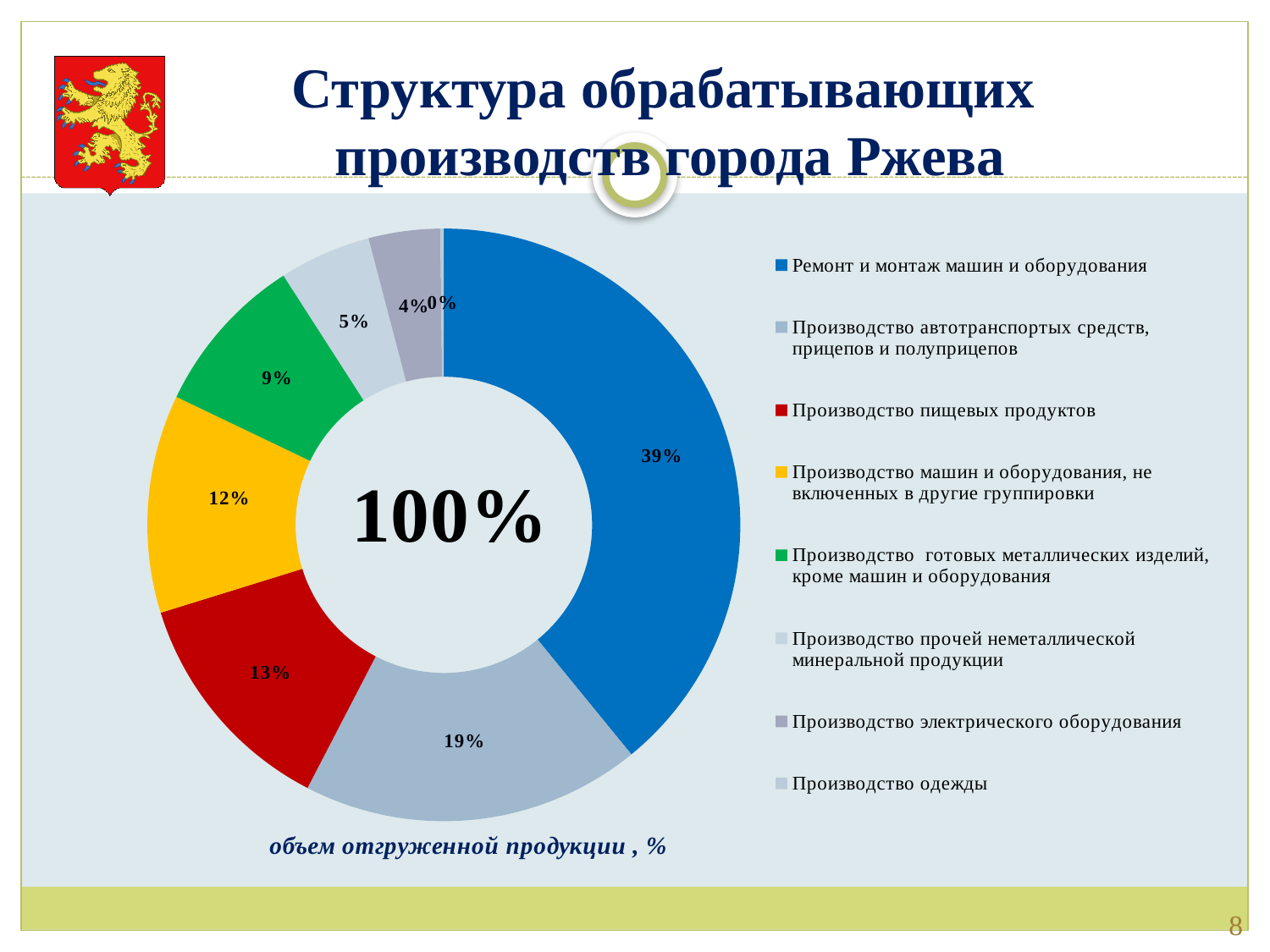
What is the value for "Производство готовых металлических изделий, кроме машин и оборудования"? 9% What is the value for "Производство пищевых продуктов"? 13% How many categories does the legend list? 8 What is the difference between the shares of "Ремонт и монтаж машин и оборудования" and "Производство автотранспортых средств, прицепов и полуприцепов"? 20% What share of shipped products does "Ремонт и монтаж машин и оборудования" account for? 39% What kind of chart is shown on the slide? Doughnut (pie) chart Which category has the largest share of the chart? Ремонт и монтаж машин и оборудования What is the value for "Производство электрического оборудования"? 4% Which category has the smallest share of the chart? Производство одежды What is the value for "Производство автотранспортых средств, прицепов и полуприцепов"? 19% What is the caption written below the chart? объем отгруженной продукции , % What is the value for "Производство машин и оборудования, не включенных в другие группировки"? 12%